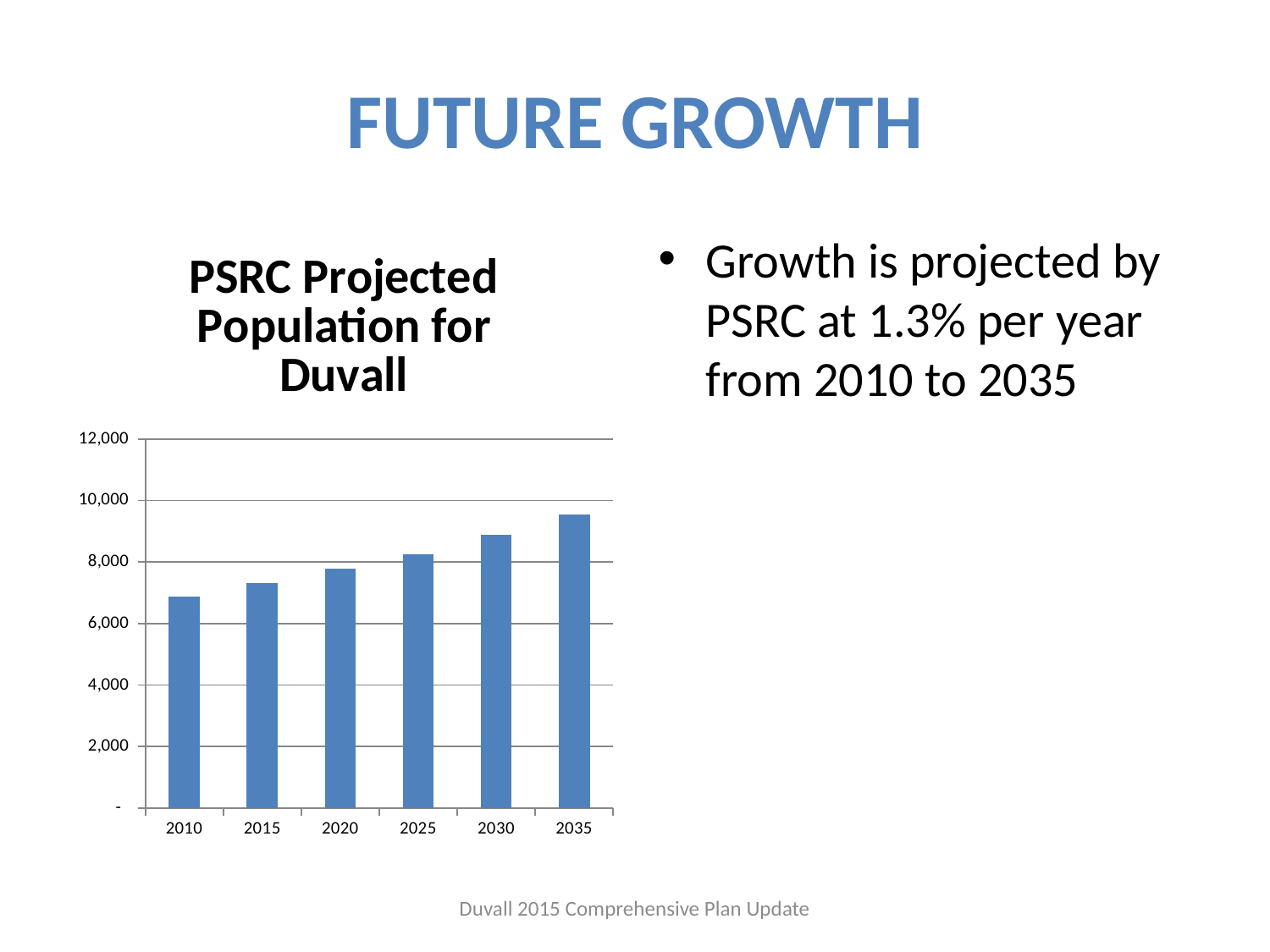
What is the title of the chart? PSRC Projected Population for Duvall Is the projected population for 2030 greater or less than 8,000? greater What type of chart is shown on the slide? Bar chart Is the projected population for 2015 greater or less than 6,000? greater Which year has the lowest projected population? 2010 How many years are shown on the x axis of the chart? 6 Is the projected population for 2010 greater or less than 8,000? less Do the projected population values rise or fall from 2010 to 2035? Rise Which year has the highest projected population? 2035 Which is larger, the projected population for 2020 or for 2030? 2030